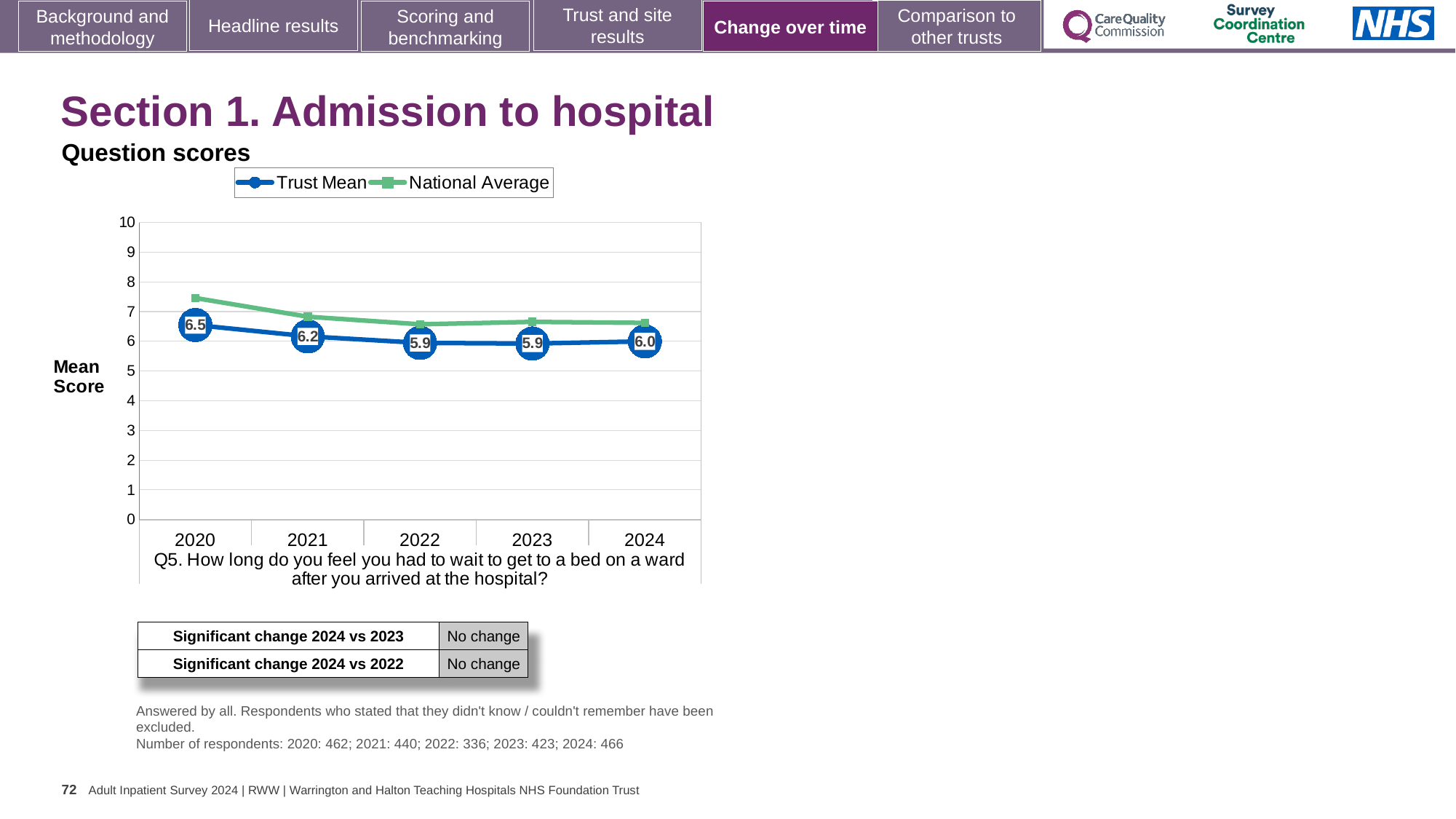
What is the Trust Mean score for 2024? 6.0 How many years are plotted on the x axis? 5 What kind of chart is shown on the slide? Line chart What is the difference between the Trust Mean score in 2020 and in 2024? 0.5 Does the Trust Mean score rise or fall from 2020 to 2022? Fall Which is larger, the Trust Mean score in 2020 or in 2021? 2020 Is the National Average value for 2020 greater or less than 7? greater In which year is the Trust Mean score highest? 2020 In 2020, which series has the higher value, Trust Mean or National Average? National Average What is the Trust Mean score for 2020? 6.5 How many series does the legend list? 2 What is the Trust Mean score for 2021? 6.2